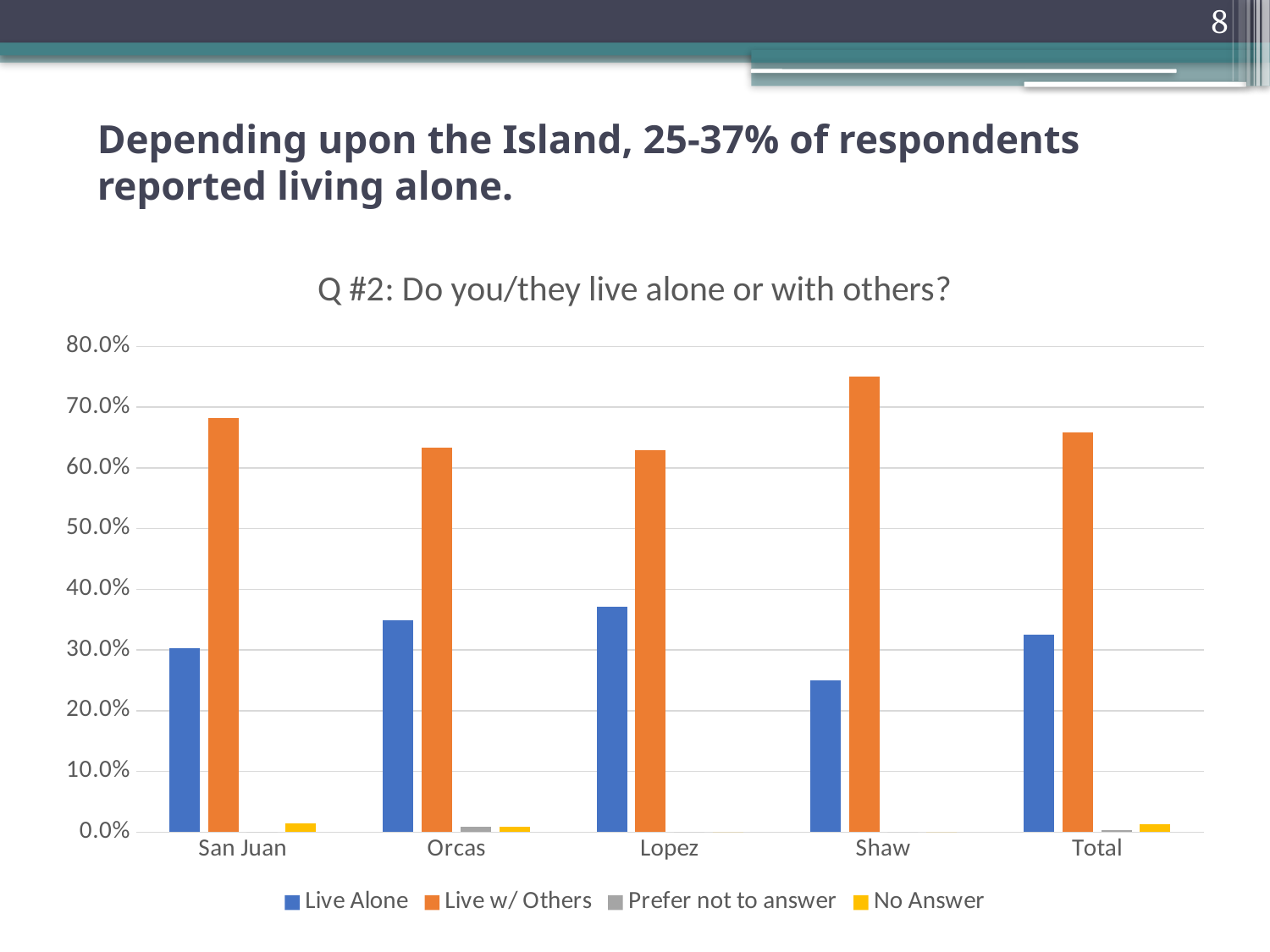
What is the title of the chart? Q #2: Do you/they live alone or with others? Is the Live w/ Others value for Orcas greater or less than 60.0%? greater What kind of chart is shown on the slide? bar chart How many series does the legend list? 4 Is the Live w/ Others value for Shaw greater or less than 70.0%? greater Is the Live Alone value for Shaw greater or less than 30.0%? less Which island has the highest Live Alone value? Lopez Which island has the lowest Live Alone value? Shaw Which is larger, the Live w/ Others value for San Juan or for Orcas? San Juan How many categories are shown on the x axis? 5 Which category has the highest Live w/ Others value? Shaw